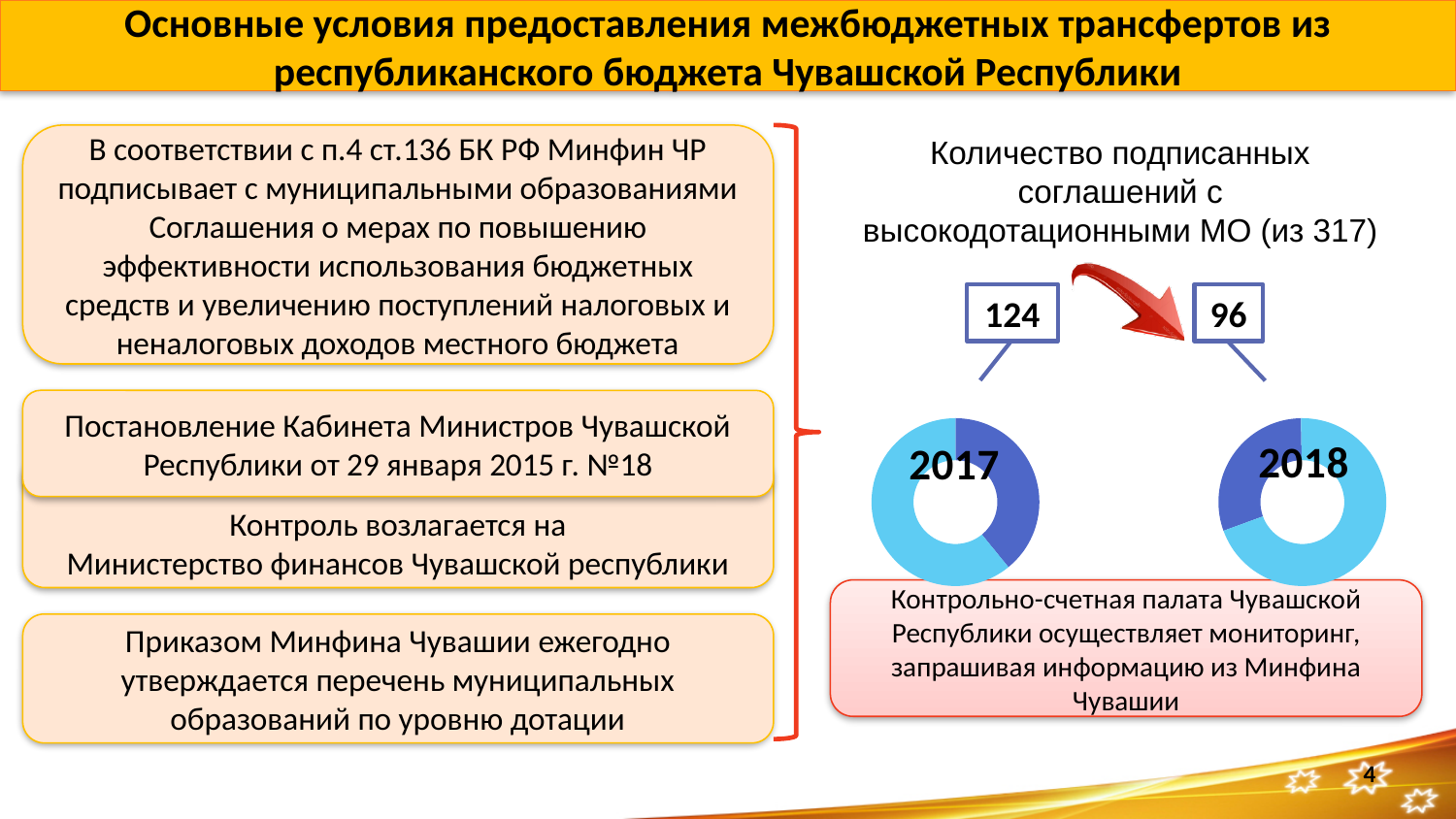
Out of how many municipalities in total are the signed agreements counted, according to the chart title? 317 Is the value for 2018 greater or less than 100? less Which year shows the higher number of signed agreements, 2017 or 2018? 2017 What is the number of signed agreements with highly subsidized municipalities shown for 2017? 124 What is the number of signed agreements with highly subsidized municipalities shown for 2018? 96 Is the value for 2017 greater or less than 100? greater Which year shows the lower number of signed agreements? 2018 Did the number of signed agreements rise or fall from 2017 to 2018? fall By how much did the number of signed agreements decrease from 2017 to 2018? 28 What is the title above the donut charts? Количество подписанных соглашений с высокодотационными МО (из 317) How many donut charts are shown on the slide? 2 What kind of chart is used to show the 2017 and 2018 values? Donut (pie) chart